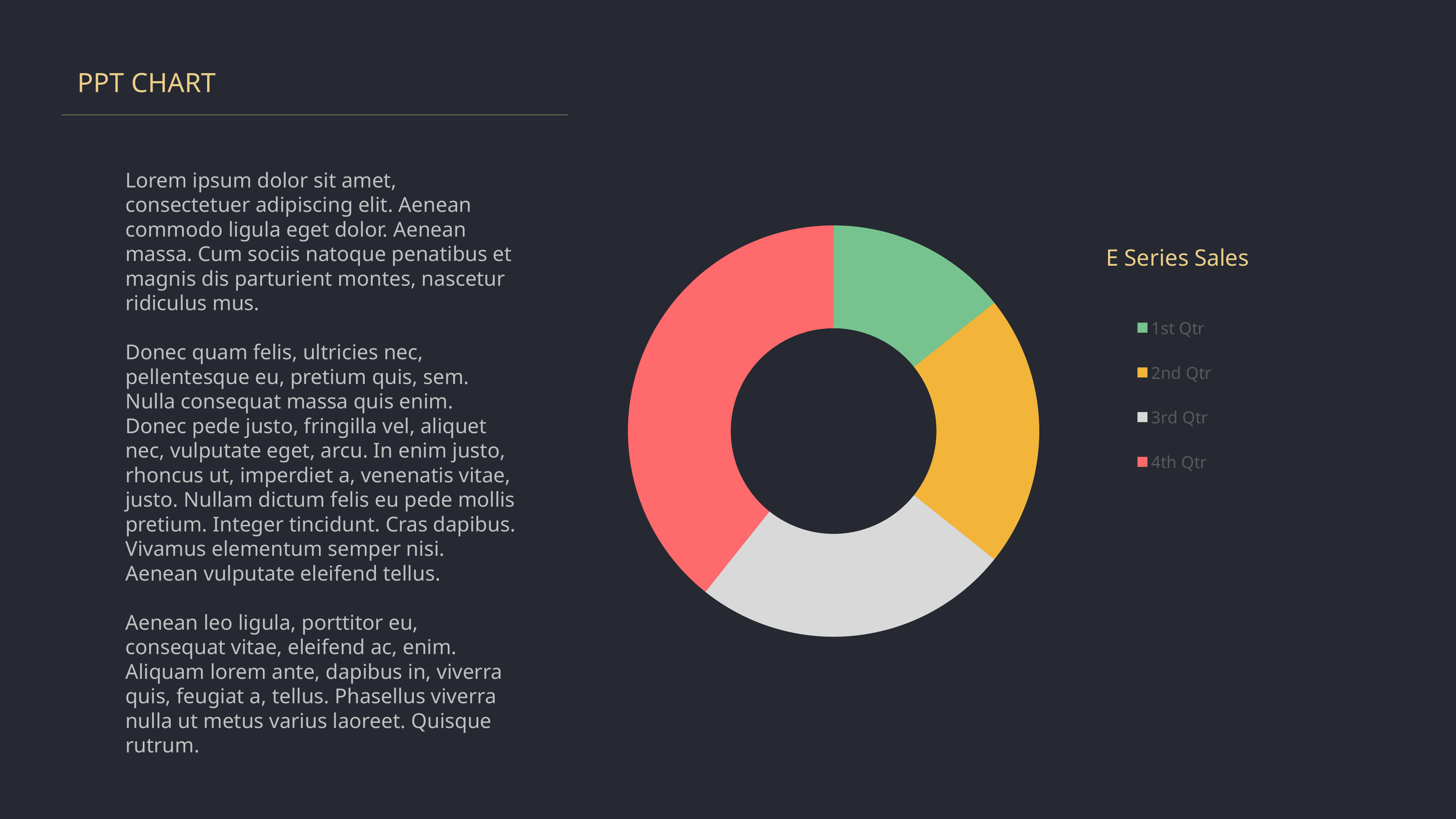
Which slice is larger, 4th Qtr or 2nd Qtr? 4th Qtr What is the title of the chart? E Series Sales What colour represents 2nd Qtr in the chart? Yellow Which quarter has the largest slice in the chart? 4th Qtr How many categories does the chart show? 4 Which slice is larger, 3rd Qtr or 1st Qtr? 3rd Qtr Which slice is larger, 4th Qtr or 1st Qtr? 4th Qtr How many entries does the legend list? 4 What kind of chart is shown on the slide? Doughnut chart Which quarter has the smallest slice in the chart? 1st Qtr